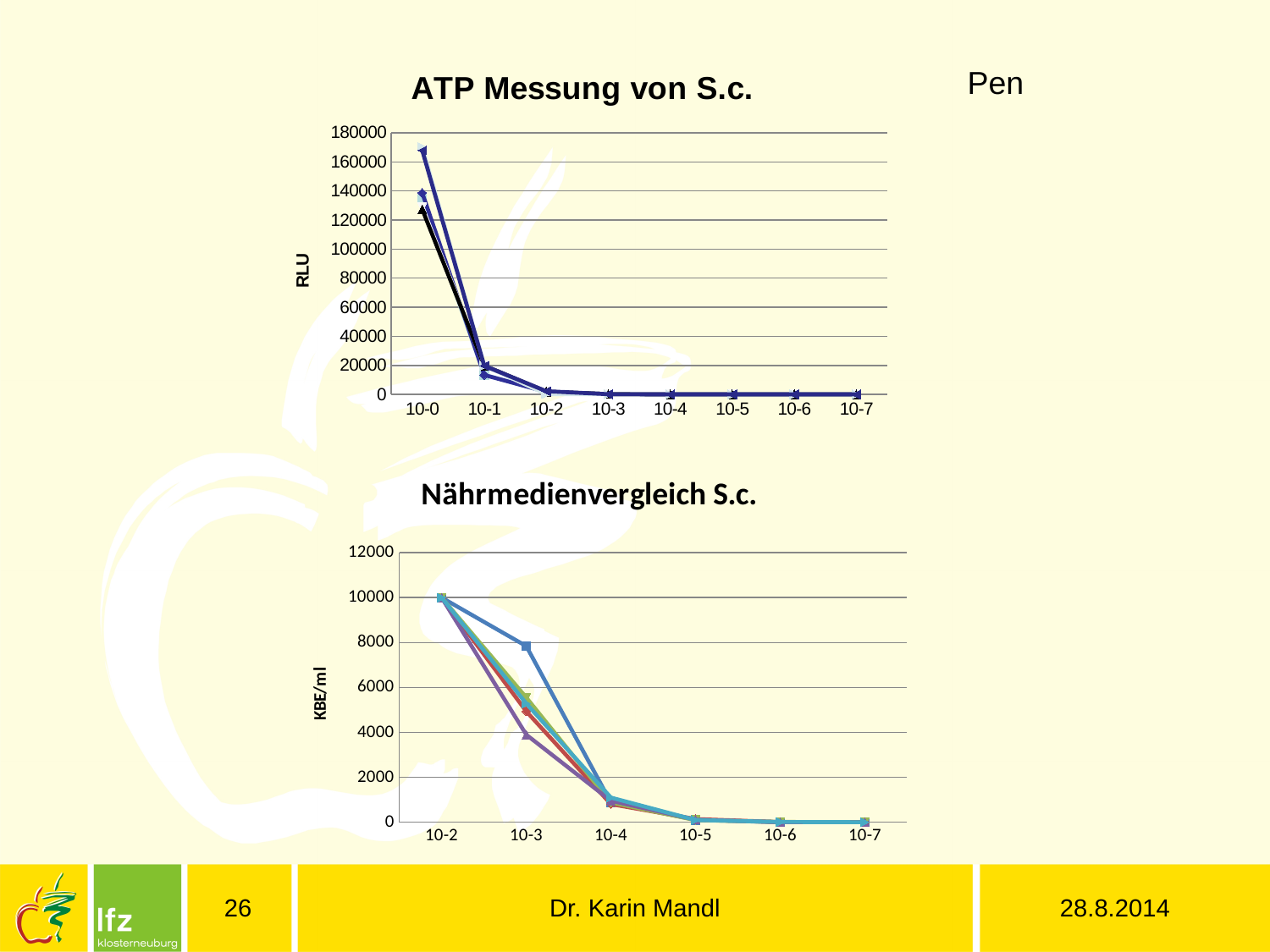
In the bottom chart "Nährmedienvergleich S.c.", which category has the highest values? 10-2 In the top chart "ATP Messung von S.c.", are the values at 10-0 greater or less than 100000? greater What type of chart is the bottom chart titled "Nährmedienvergleich S.c."? line chart In the top chart "ATP Messung von S.c.", how many categories are shown on the x axis? 8 In the bottom chart "Nährmedienvergleich S.c.", do the values rise or fall along the x axis from 10-2 to 10-7? fall In the bottom chart "Nährmedienvergleich S.c.", are the values at 10-4 greater or less than 2000? less In the top chart "ATP Messung von S.c.", do the values rise or fall along the x axis from 10-0 to 10-7? fall In the top chart "ATP Messung von S.c.", which category has the highest values? 10-0 What is the y-axis label of the top chart "ATP Messung von S.c."? RLU In the bottom chart "Nährmedienvergleich S.c.", what is the value in KBE/ml at 10-2? 10000 What type of chart is the top chart titled "ATP Messung von S.c."? line chart In the bottom chart "Nährmedienvergleich S.c.", how many categories are shown on the x axis? 6